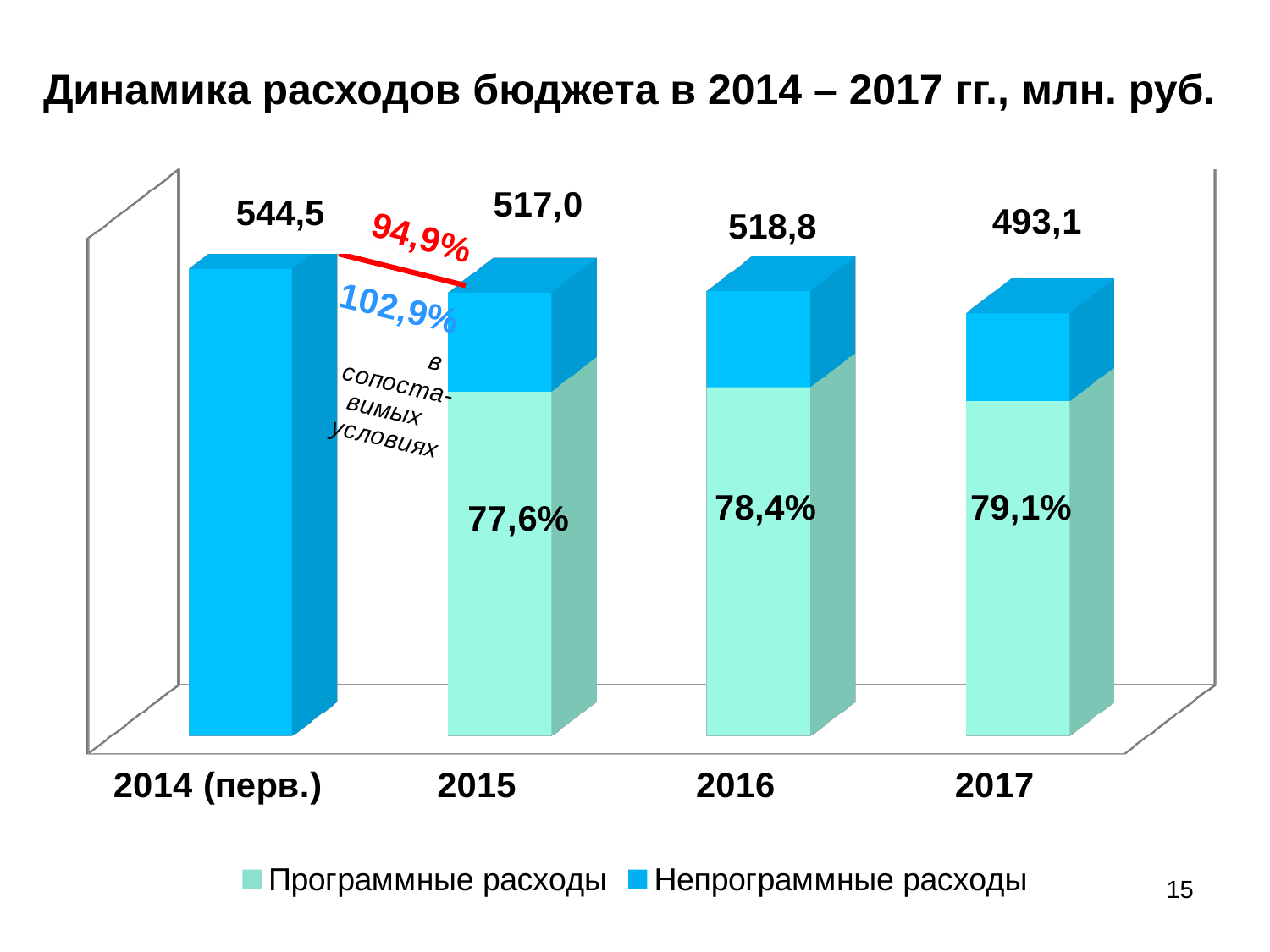
What is the total budget expenditure shown for 2017? 493,1 What percentage is written in red between the 2014 (перв.) and 2015 bars? 94,9% Which year has the lowest total budget expenditure? 2017 How many series does the legend list? 2 What is the total budget expenditure shown for 2015? 517,0 What kind of chart is shown on the slide? Stacked bar chart Which year has the highest total budget expenditure? 2014 (перв.) What is the difference between the total expenditure in 2014 (перв.) and in 2017? 51,4 How many years (categories) are shown on the x axis? 4 Does the share of Программные расходы rise or fall from 2015 to 2017? Rises Which year has the larger total expenditure, 2015 or 2016? 2016 What share of expenditure is labelled as Программные расходы in 2016? 78,4%